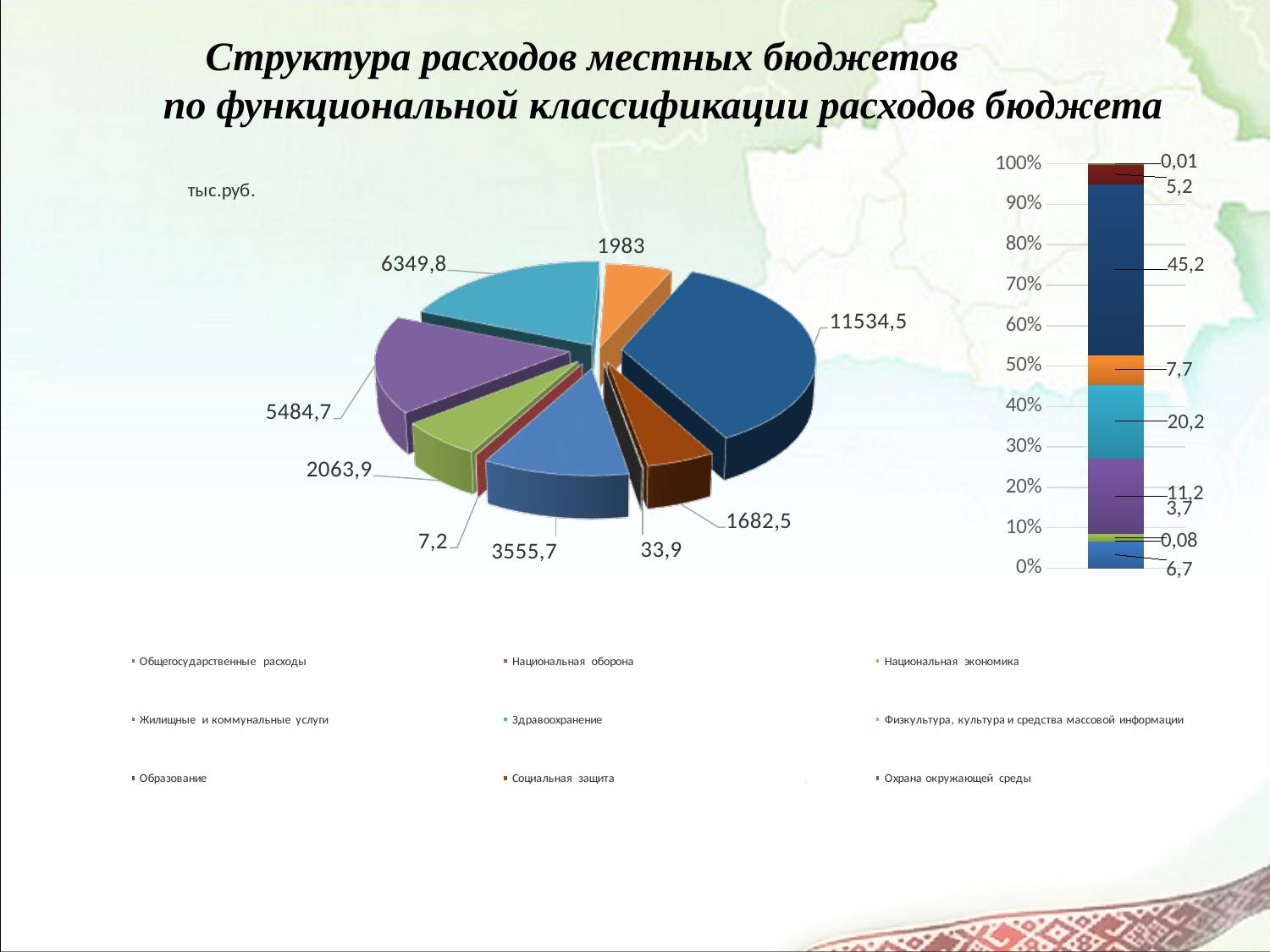
In the pie chart on the left, which is larger: the slice labelled 5484,7 or the slice labelled 3555,7? 5484,7 In the pie chart on the left, what is the largest labelled value? 11534,5 What kind of chart is the chart on the right of the slide with the percentage axis? Bar chart What unit is shown next to the pie chart on the left? тыс.руб. What kind of chart is the chart on the left of the slide? Pie chart In the stacked bar chart on the right, what is the largest segment value? 45,2 In the pie chart on the left, what is the smallest labelled value? 7,2 In the stacked bar chart on the right, what is the smallest segment value? 0,01 In the stacked bar chart on the right, what is the difference between the segments labelled 20,2 and 7,7? 12,5 How many entries does the legend at the bottom of the slide list? 9 In the pie chart on the left, what is the difference between the largest value (11534,5) and the value 6349,8? 5184,7 In the pie chart on the left, how many slices are there? 9